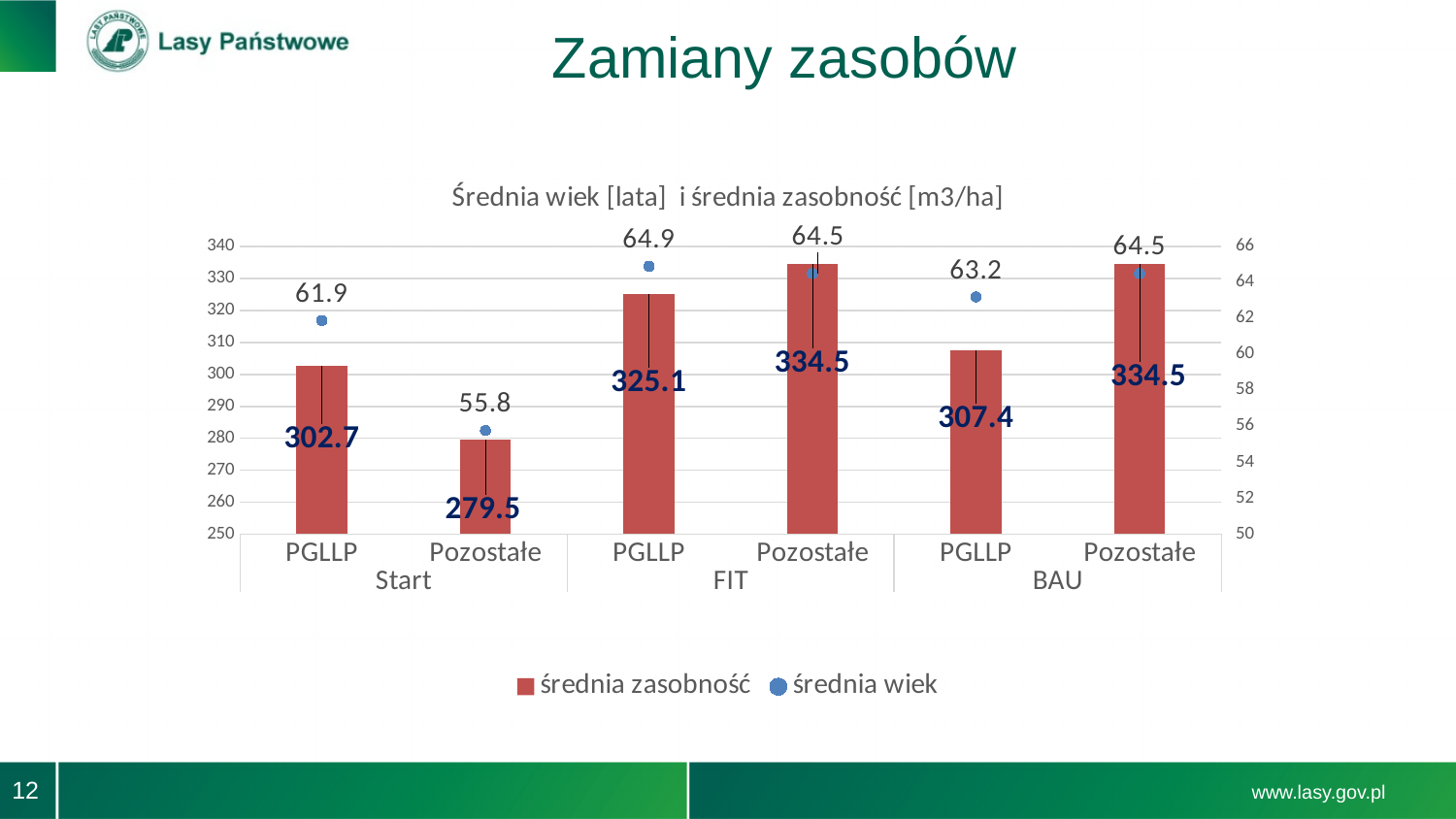
How many series does the legend list? 2 How many categories are shown on the x axis of the chart? 6 Which category has the highest średnia wiek value? PGLLP (FIT) What is the średnia wiek value for Pozostałe in the FIT group? 64.5 What is the difference between the średnia zasobność values for PGLLP and Pozostałe in the Start group? 23.2 What is the title of the chart? Średnia wiek [lata] i średnia zasobność [m3/ha] Which category has the lowest średnia zasobność value? Pozostałe (Start) What is the difference between the średnia zasobność values for Pozostałe and PGLLP in the FIT group? 9.4 What is the średnia zasobność value for PGLLP in the Start group? 302.7 What is the średnia zasobność value for PGLLP in the BAU group? 307.4 Which has a larger średnia wiek value: PGLLP in the BAU group or PGLLP in the Start group? PGLLP in the BAU group Which category has the lowest średnia wiek value? Pozostałe (Start)